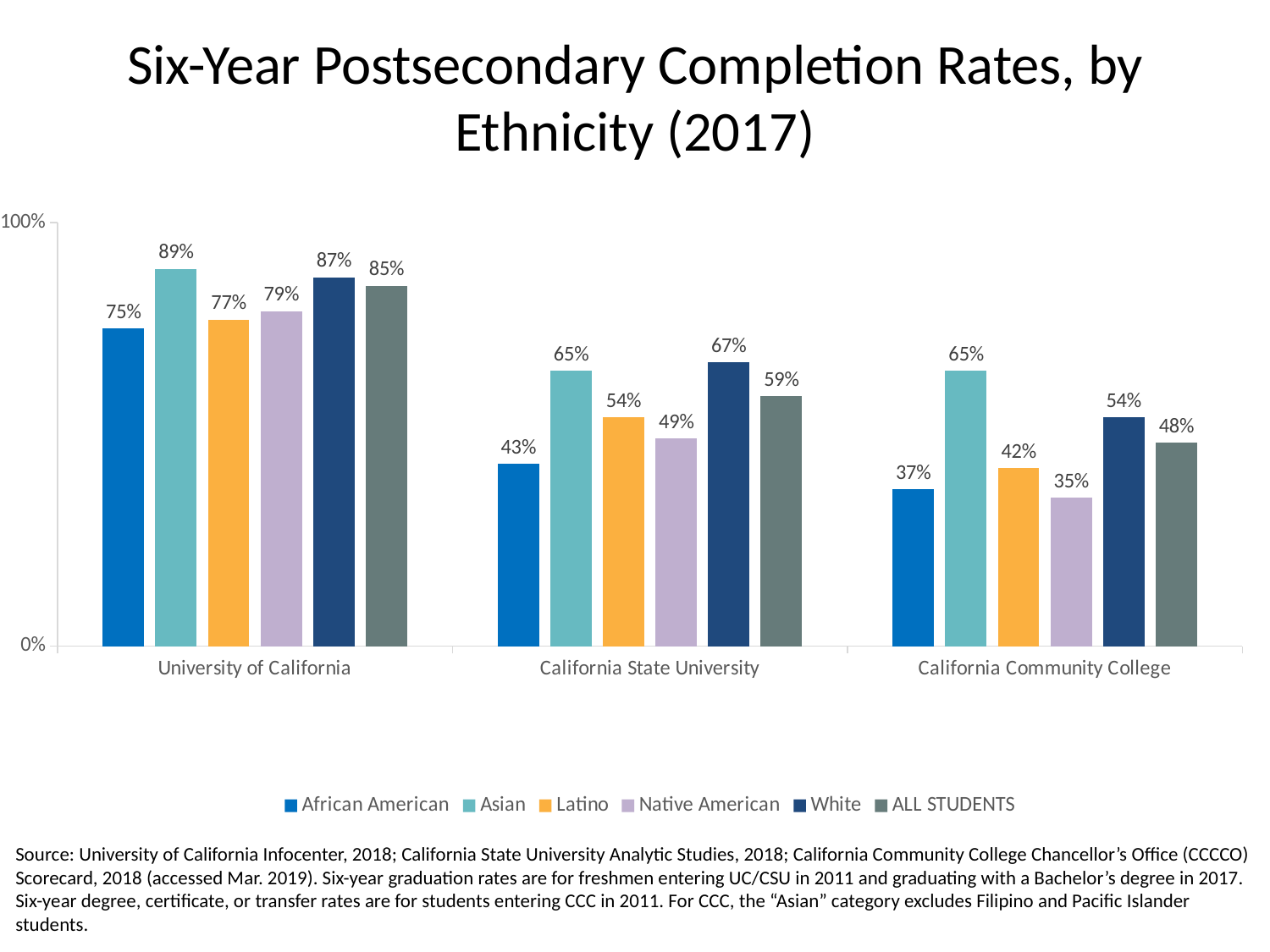
Which ethnic group has the highest six-year completion rate at California State University? White How many series does the legend list? 6 Which is larger at California Community College: the completion rate for Latino students or for White students? White How many institution categories are shown on the x axis? 3 What kind of chart is shown on the slide? Bar chart What colour represents the White series in the chart? Dark blue Which ethnic group has the lowest six-year completion rate at California Community College? Native American What is the six-year completion rate for African American students at California State University? 43% What is the difference between the completion rates for Asian and African American students at the University of California? 14% What is the six-year completion rate for Asian students at the University of California? 89% What is the six-year completion rate for Native American students at California Community College? 35% What is the completion rate for ALL STUDENTS at California State University? 59%